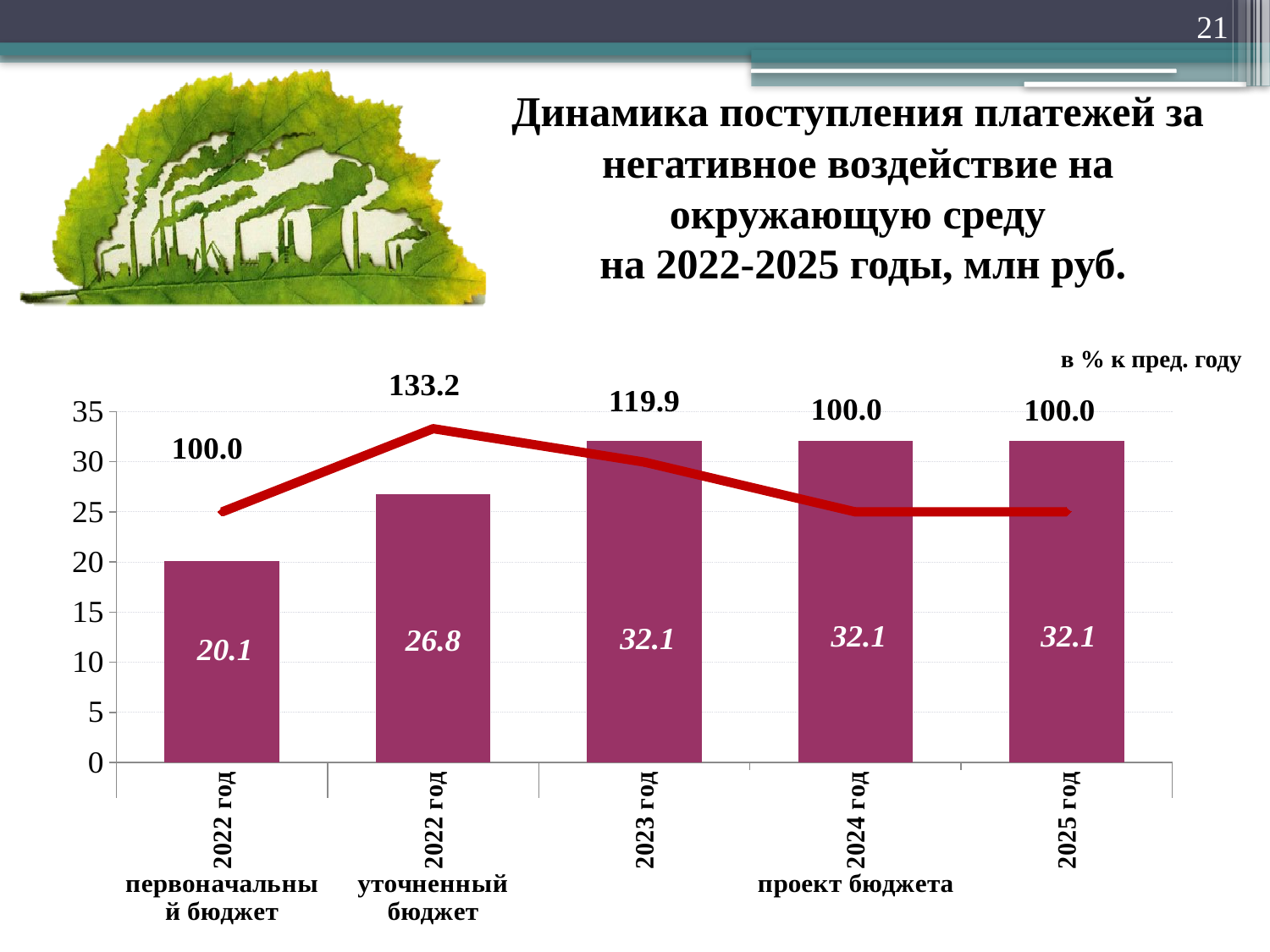
What is the difference between the bar values for 2023 год and 2022 год (уточненный бюджет)? 5.3 Do the bar values rise or fall from 2022 год (первоначальный бюджет) to 2023 год? rise What is the value of the line (в % к пред. году) for 2022 год (уточненный бюджет)? 133.2 What is the value of the bar for 2022 год (первоначальный бюджет)? 20.1 Which is larger: the bar value for 2022 год (уточненный бюджет) or for 2022 год (первоначальный бюджет)? 2022 год (уточненный бюджет) What is the value of the line (в % к пред. году) for 2023 год? 119.9 Which category has the highest value on the line (в % к пред. году)? 2022 год (уточненный бюджет) How many bars are plotted on the chart? 5 Which category has the lowest bar value? 2022 год (первоначальный бюджет) What is the value of the bar for 2024 год? 32.1 What is the value of the bar for 2022 год (уточненный бюджет)? 26.8 What kind of chart is shown on the slide? Combined bar and line chart